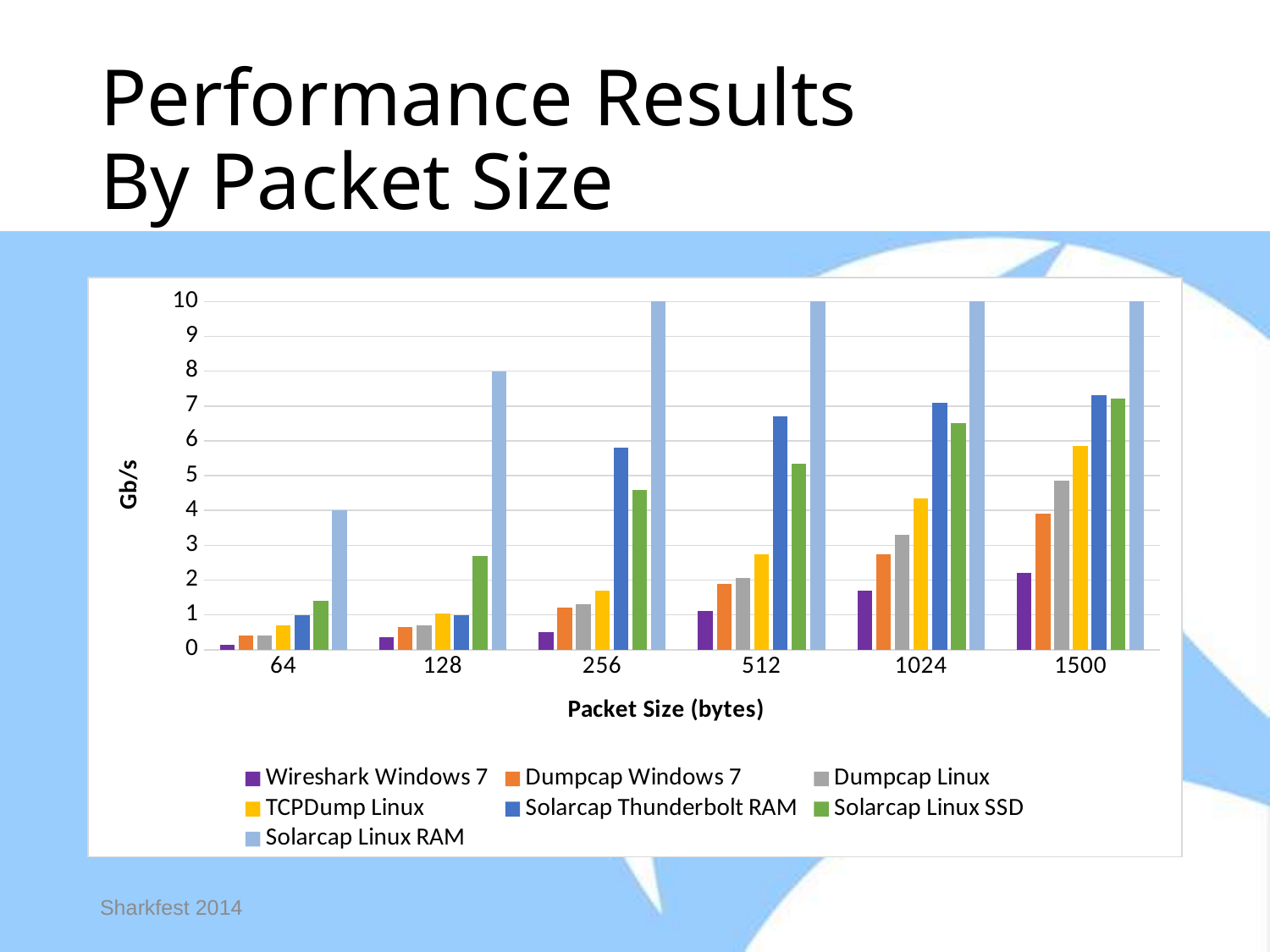
What kind of chart is shown on the slide? bar chart Do the values for Wireshark Windows 7 rise or fall as packet size increases? rise What is the value for Solarcap Linux RAM at packet size 1500? 10 At packet size 1500, which is larger: Dumpcap Windows 7 or Dumpcap Linux? Dumpcap Linux How many packet size categories are shown on the x axis? 6 How many series does the legend list? 7 What is the value for Solarcap Linux RAM at packet size 64? 4 Which series has the highest value at packet size 512? Solarcap Linux RAM What is the value for Solarcap Linux RAM at packet size 128? 8 Which series has the lowest value at packet size 64? Wireshark Windows 7 Is the value for Solarcap Thunderbolt RAM at packet size 256 greater or less than 5? greater Is the value for TCPDump Linux at packet size 1024 greater or less than 5? less